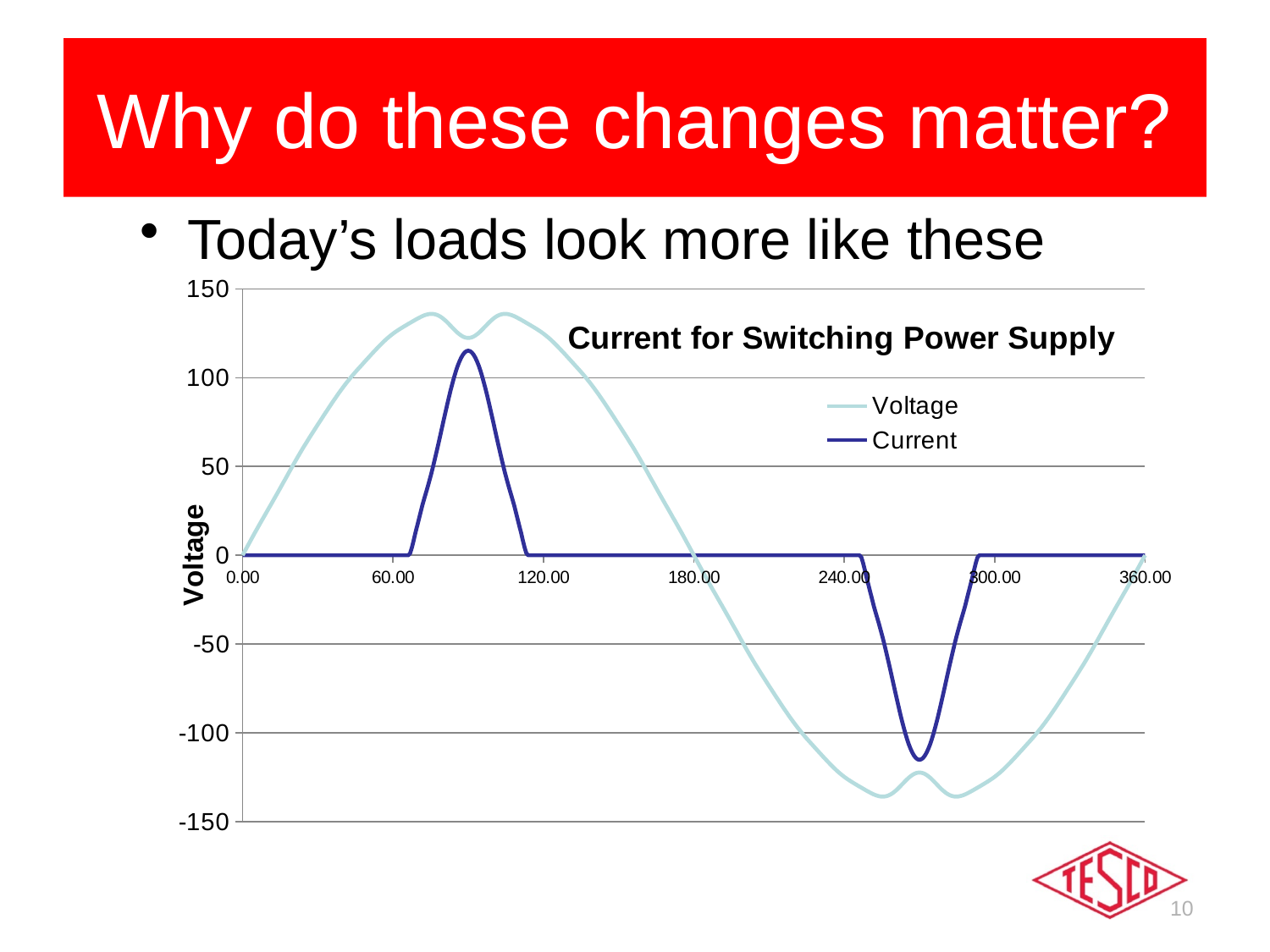
What is the title of the chart? Current for Switching Power Supply What is the Voltage value at x = 180.00? 0 What are the two series named in the chart legend? Voltage and Current How many tick labels are shown on the x axis? 7 Is the peak value of the Voltage series greater or less than 100? greater How many series does the chart legend list? 2 Is the peak value of the Current series greater or less than 150? less Which series reaches a higher maximum value, Voltage or Current? Voltage What kind of chart is shown on the slide? line chart Is the Voltage value at x = 240.00 greater or less than -100? less What is the Current value at x = 0.00? 0